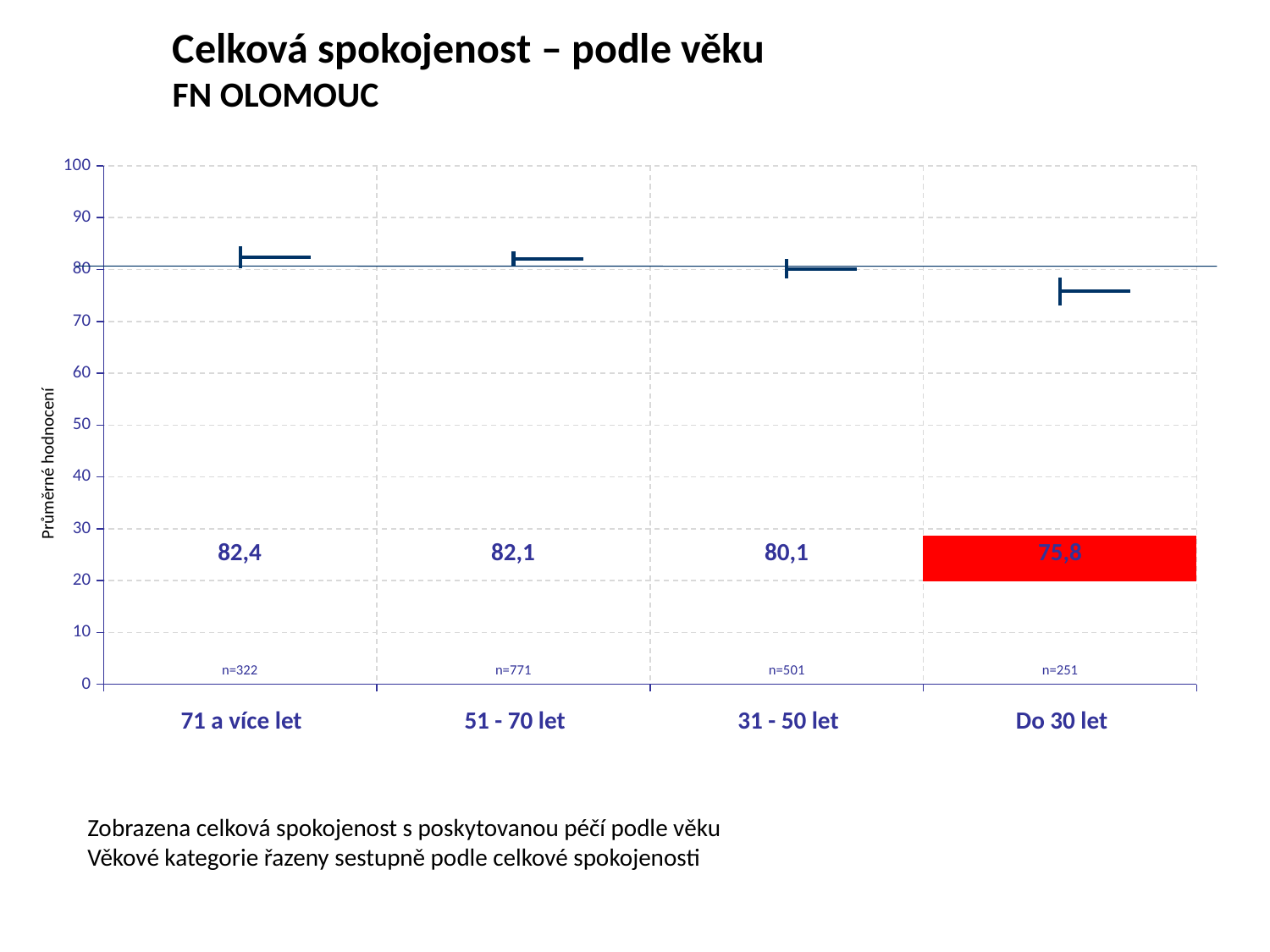
What is the sample size (n) shown for the age group 51 - 70 let? n=771 What is the average rating for the age group 51 - 70 let? 82,1 Which has a higher average rating, 31 - 50 let or Do 30 let? 31 - 50 let What is the average rating for the age group Do 30 let? 75,8 Do the average ratings rise or fall from left to right across the age categories? fall What is the label of the vertical axis? Průměrné hodnocení Which age group has the lowest average rating? Do 30 let How many age categories are shown on the chart? 4 Which age group has the highest average rating? 71 a více let What is the average rating for the age group 71 a více let? 82,4 What is the average rating for the age group 31 - 50 let? 80,1 What is the difference between the average rating for 71 a více let and Do 30 let? 6,6